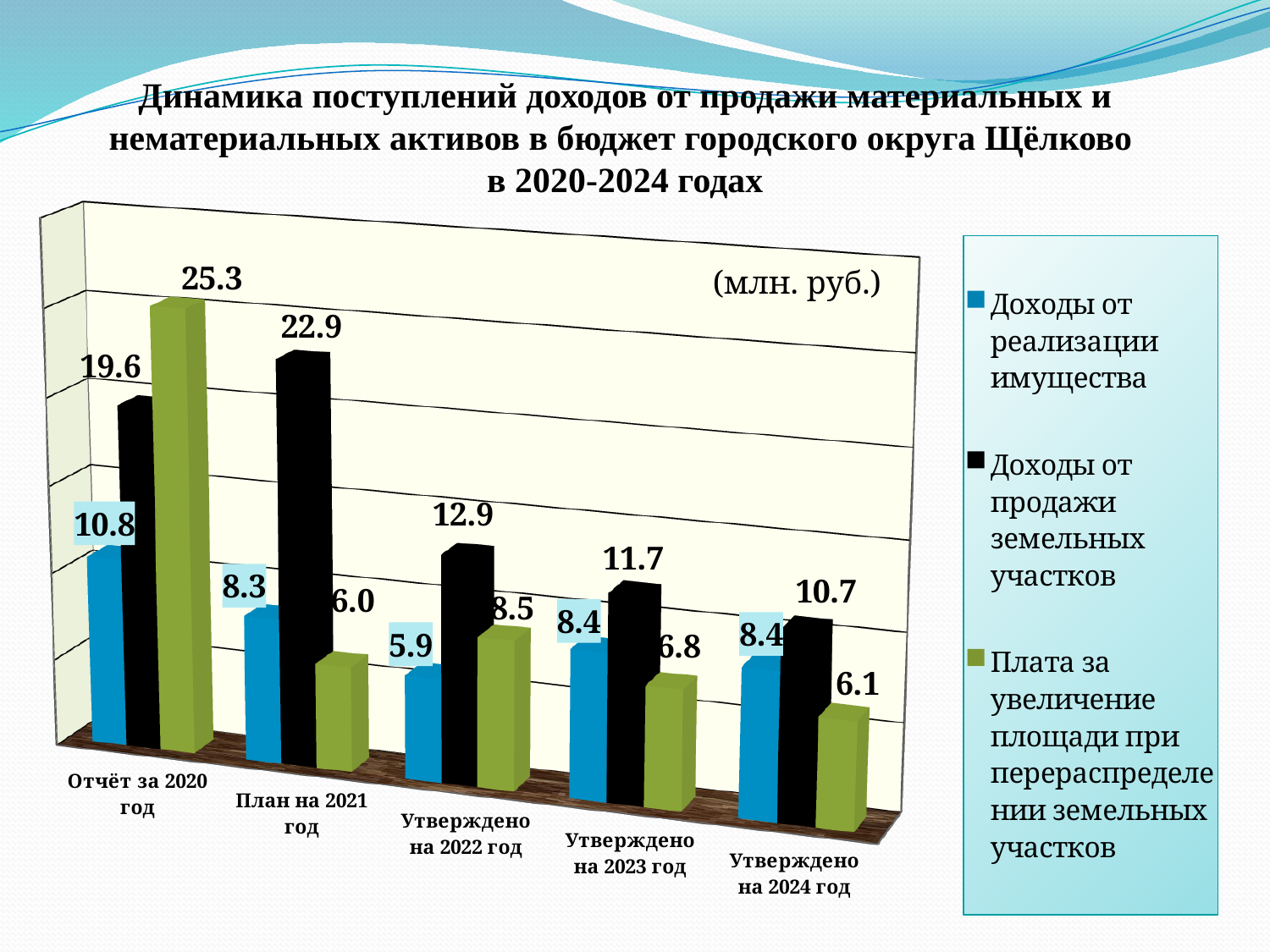
What is the value for Доходы от продажи земельных участков in Утверждено на 2024 год? 10.7 Which is larger: Доходы от реализации имущества in Отчёт за 2020 год or in План на 2021 год? Отчёт за 2020 год What kind of chart is shown on the slide? Bar chart Which category has the lowest value for Доходы от реализации имущества? Утверждено на 2022 год How many series does the legend list? 3 What unit is indicated on the chart? млн. руб. What is the value for Доходы от реализации имущества in Отчёт за 2020 год? 10.8 What is the value for Плата за увеличение площади при перераспределении земельных участков in Утверждено на 2023 год? 6.8 What is the difference between Доходы от продажи земельных участков in План на 2021 год and in Утверждено на 2022 год? 10.0 What is the value for Доходы от продажи земельных участков in План на 2021 год? 22.9 How many categories are shown on the x axis? 5 Which category has the highest value for Плата за увеличение площади при перераспределении земельных участков? Отчёт за 2020 год